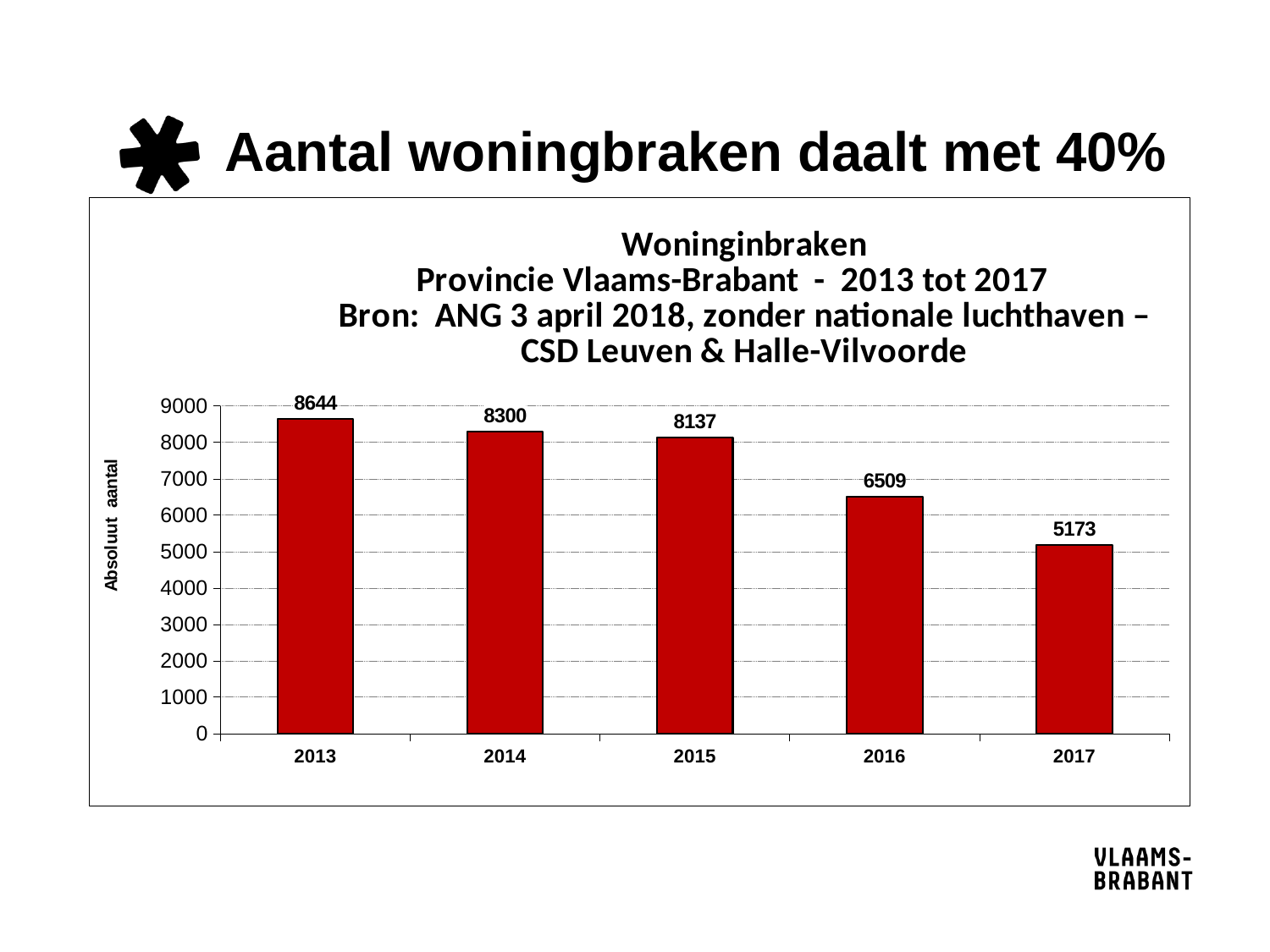
What is the difference between the values for 2013 and 2017? 3471 Which is larger, the value for 2014 or the value for 2015? 2014 What kind of chart is this? bar chart How many years are shown on the x axis? 5 What is the value for 2013? 8644 What is the value for 2016? 6509 Do the values rise or fall from 2013 to 2017? fall Which year has the highest value? 2013 Which year has the lowest value? 2017 What is the value for 2017? 5173 Is the value for 2016 greater or less than 7000? less What is the difference between the values for 2015 and 2016? 1628